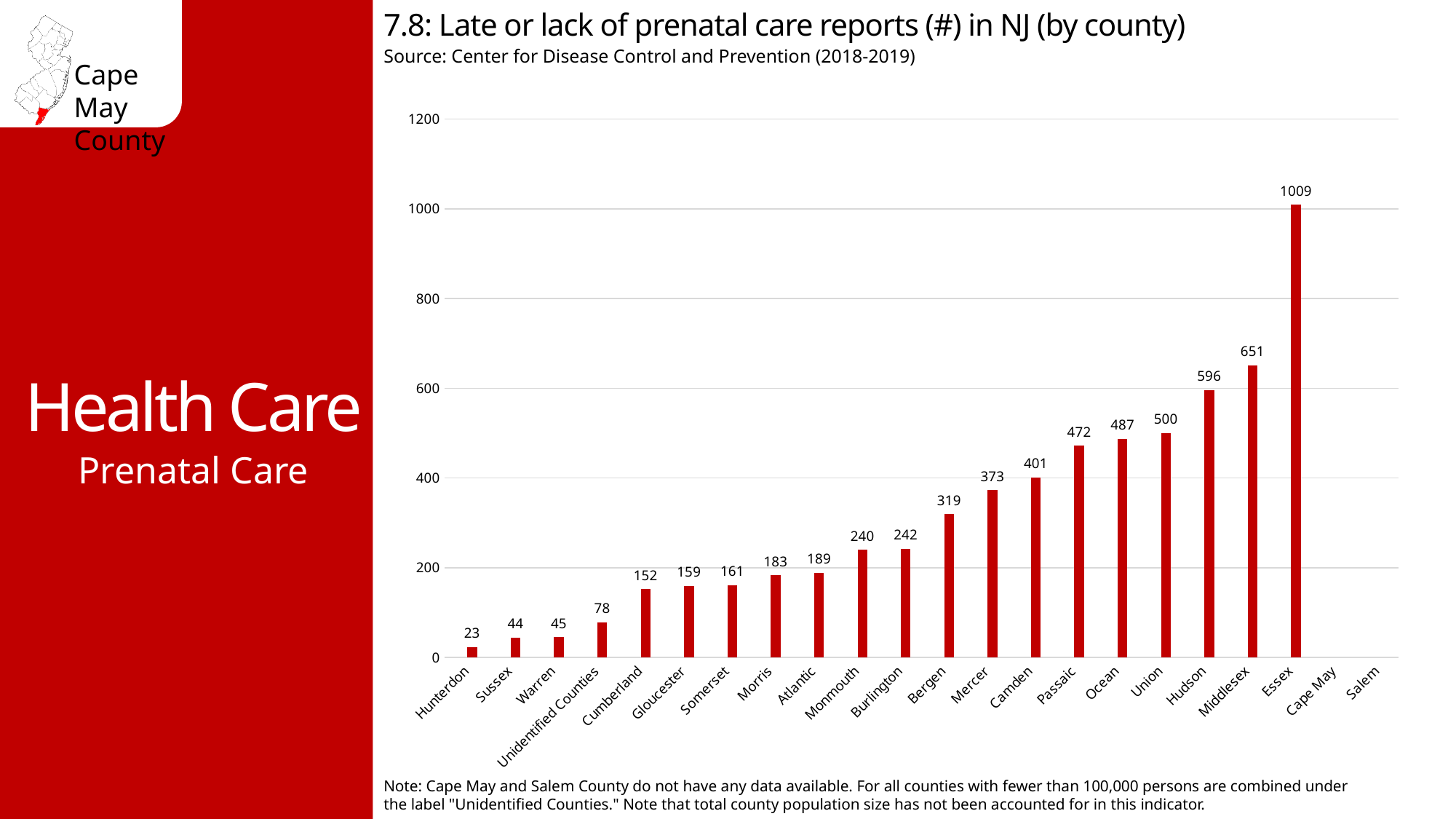
What is the difference between the values for Essex and Middlesex? 358 How many county categories are listed on the x axis? 22 What is the number of late or lack of prenatal care reports for Hunterdon? 23 Which county has the highest number of late or lack of prenatal care reports? Essex What is the number of late or lack of prenatal care reports for Essex? 1009 Among counties with a plotted bar, which has the lowest number of reports? Hunterdon Which has a larger value, Hudson or Union? Hudson Do the values generally rise or fall moving from left to right along the x axis? Rise What is the value shown for Unidentified Counties? 78 Is the value for Passaic greater or less than 400? greater What is the value shown for Middlesex? 651 What kind of chart is shown on the slide? Bar chart